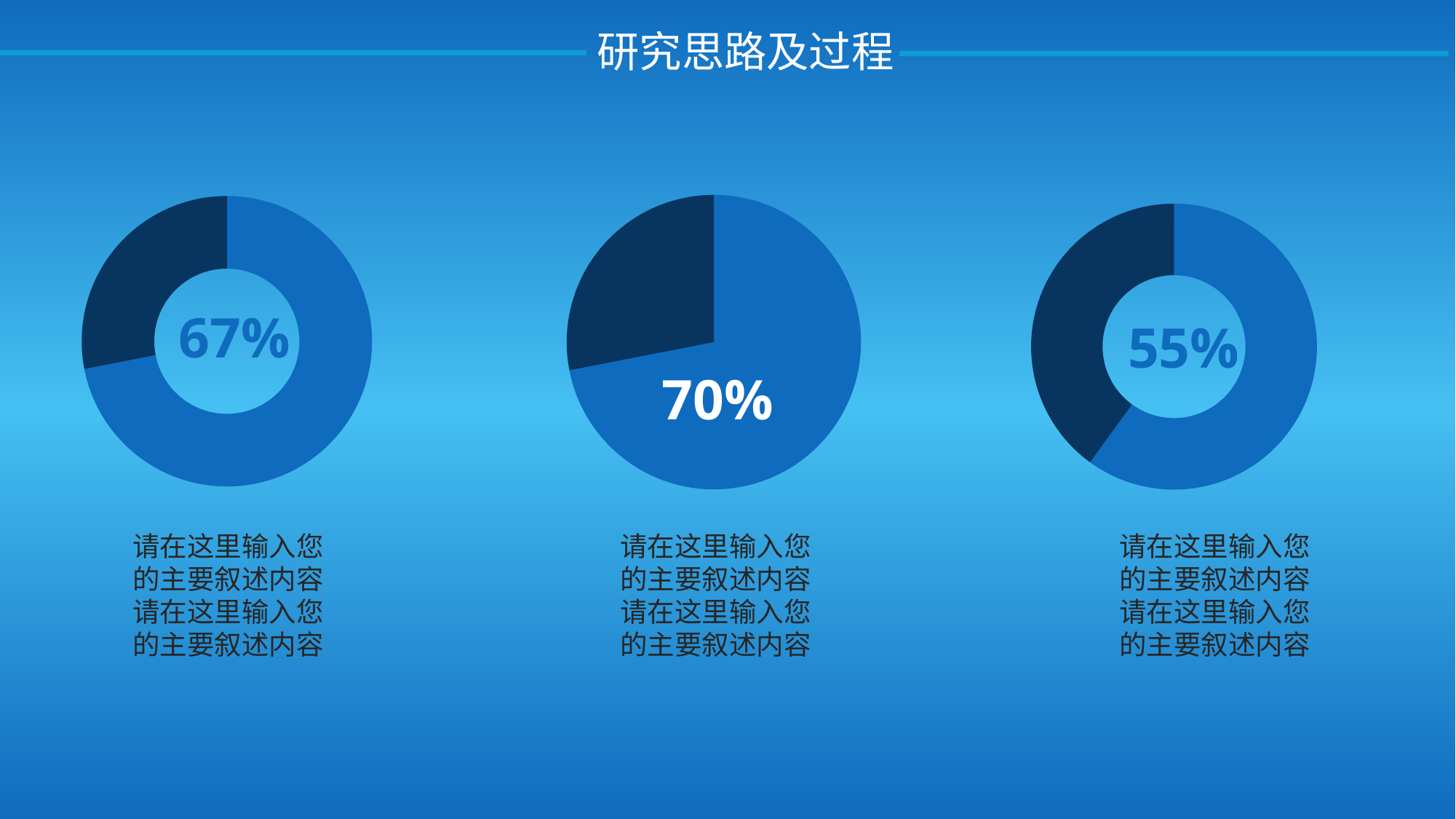
What kind of chart is the middle chart on the slide? pie chart What percentage is printed in the centre of the left doughnut chart? 67% Is the percentage on the left chart larger or smaller than the percentage on the right chart? larger Which of the three charts shows the highest printed percentage? the middle chart (70%) How many charts are shown on the slide? 3 What is the difference between the percentage on the middle chart and the percentage on the right chart? 15% What percentage is printed on the middle pie chart? 70% How many slices does the middle pie chart have? 2 How many slices does the left doughnut chart have? 2 What percentage is printed in the centre of the right doughnut chart? 55% Which of the three charts shows the lowest printed percentage? the right chart (55%) What kind of chart is the left chart on the slide? doughnut chart